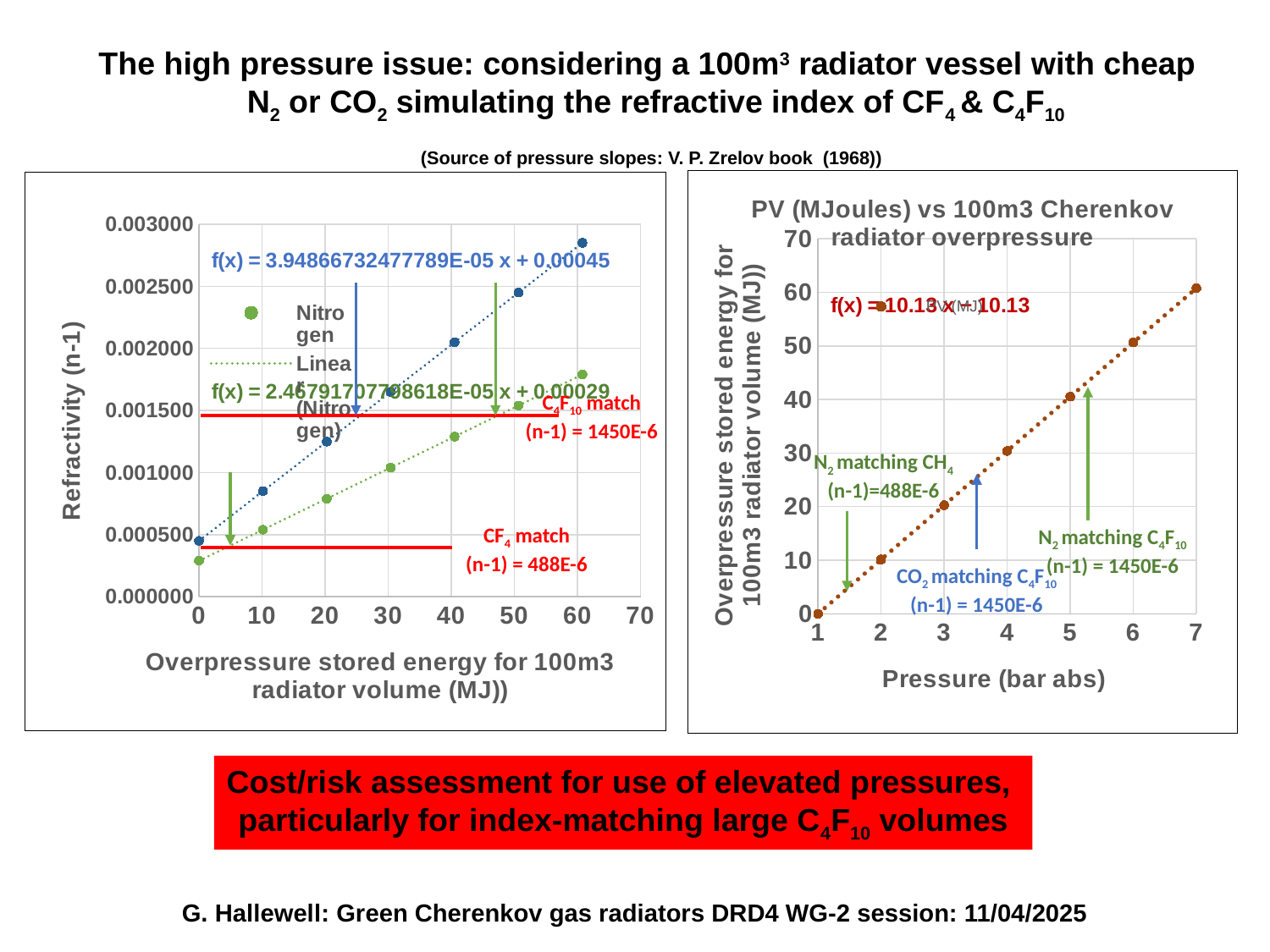
In the chart on the right, is the value at 6 bar abs greater or less than 40? greater In the chart on the right, is the value at 2 bar abs greater or less than 20? less In the chart on the right, what is the trendline equation shown? f(x) = 10.13x - 10.13 In the chart on the left, what refractivity value is given for the C4F10 match line? (n-1) = 1450E-6 What is the title of the chart on the right? PV (MJoules) vs 100m3 Cherenkov radiator overpressure In the chart on the right, how many data points are plotted? 7 In the chart on the right, do the values rise or fall as pressure increases? rise In the chart on the right, is the value at 4 bar abs greater or less than 40? less In the chart on the left, what refractivity value is given for the CF4 match line? (n-1) = 488E-6 In the chart on the right, what is the x-axis label? Pressure (bar abs)